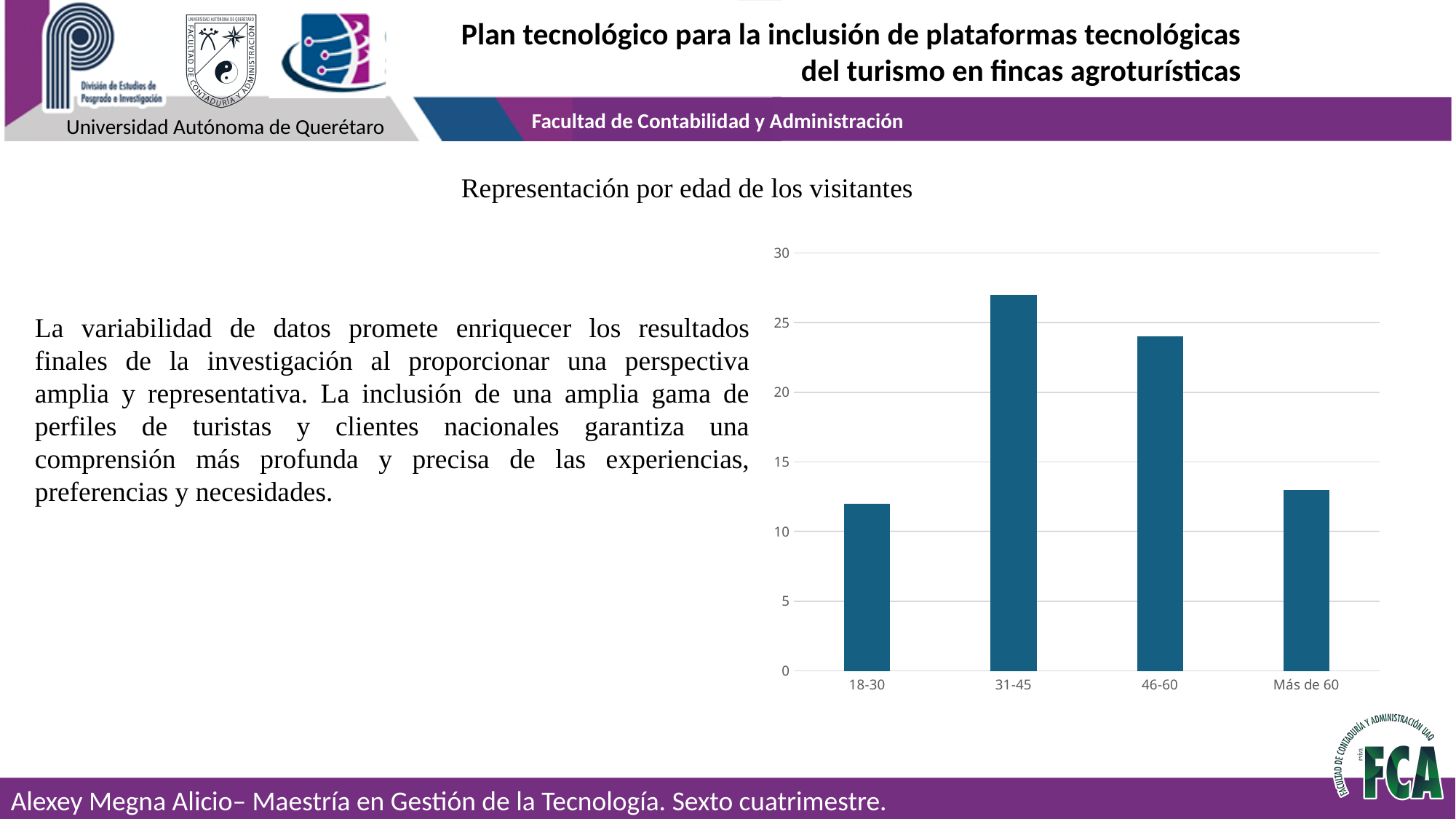
Is the value for 18-30 greater or less than 10? greater What is the title of the chart on the slide? Representación por edad de los visitantes Which age category has the highest bar in the chart? 31-45 How many age categories are shown on the x axis of the chart? 4 Is the value for 46-60 greater or less than 20? greater Which is larger, the value for 18-30 or the value for 31-45? 31-45 Is the value for 31-45 greater or less than 25? greater Which is larger, the value for 31-45 or the value for 46-60? 31-45 What kind of chart is shown on the slide? bar chart